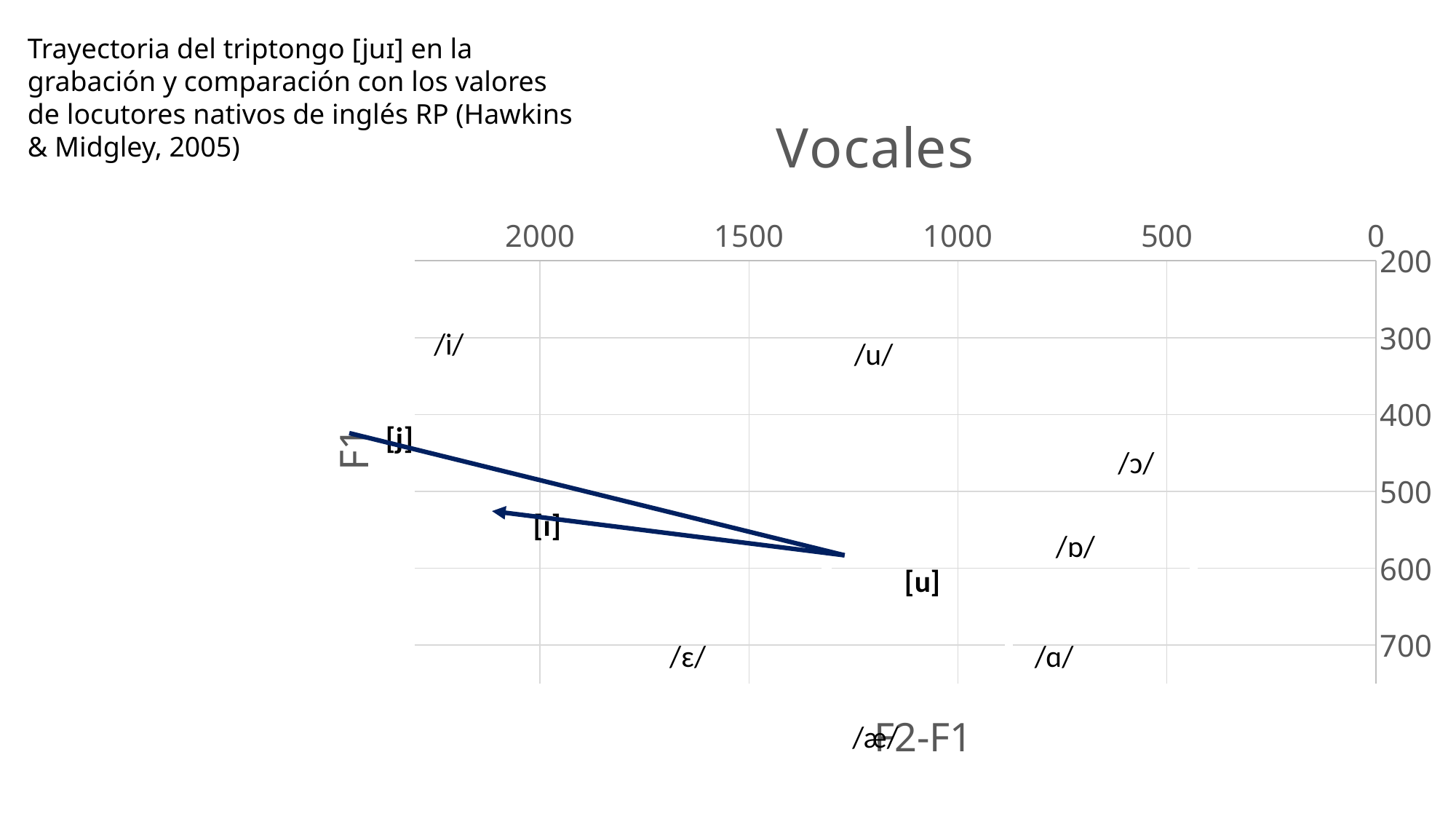
Is the F2-F1 value for /ɔ/ greater or less than 1000? less Which has the larger F1 value, /ɛ/ or /ɔ/? /ɛ/ Is the F2-F1 value for /ɛ/ greater or less than 1000? greater How many labelled points make up the triptongo trajectory drawn with arrows? 3 Is the F2-F1 value for /u/ greater or less than 1500? less Which point of the triptongo trajectory ([j], [u], [ɪ]) has the highest F1 value? [u] What is the title of the chart? Vocales What kind of chart is shown on the slide? scatter chart What is the label of the horizontal axis of the chart? F2-F1